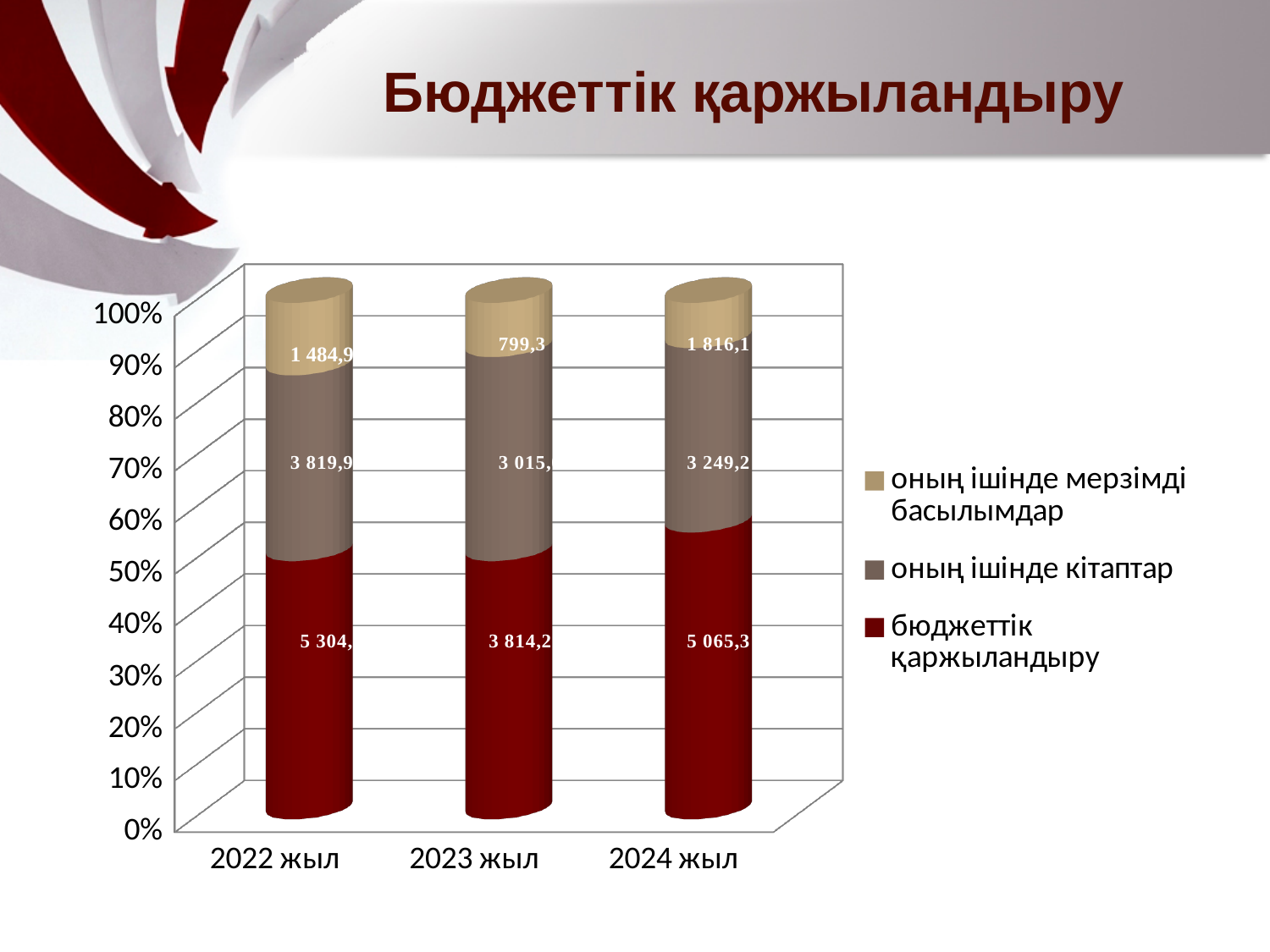
How many series does the legend list? 3 What is the value for "оның ішінде кітаптар" in 2024 жыл? 3 249,2 What is the value for "оның ішінде мерзімді басылымдар" in 2023 жыл? 799,3 What is the value for "оның ішінде мерзімді басылымдар" in 2024 жыл? 1 816,1 In which year is the value for "оның ішінде мерзімді басылымдар" the highest? 2024 жыл What is the value for "бюджеттік қаржыландыру" in 2024 жыл? 5 065,3 What is the value for "оның ішінде мерзімді басылымдар" in 2022 жыл? 1 484,9 What is the value for "оның ішінде кітаптар" in 2022 жыл? 3 819,9 In which year is the value for "оның ішінде мерзімді басылымдар" the lowest? 2023 жыл What is the difference between the "оның ішінде мерзімді басылымдар" values for 2024 жыл and 2023 жыл? 1 016,8 What kind of chart is shown on the slide? Stacked bar chart What is the value for "бюджеттік қаржыландыру" in 2023 жыл? 3 814,2